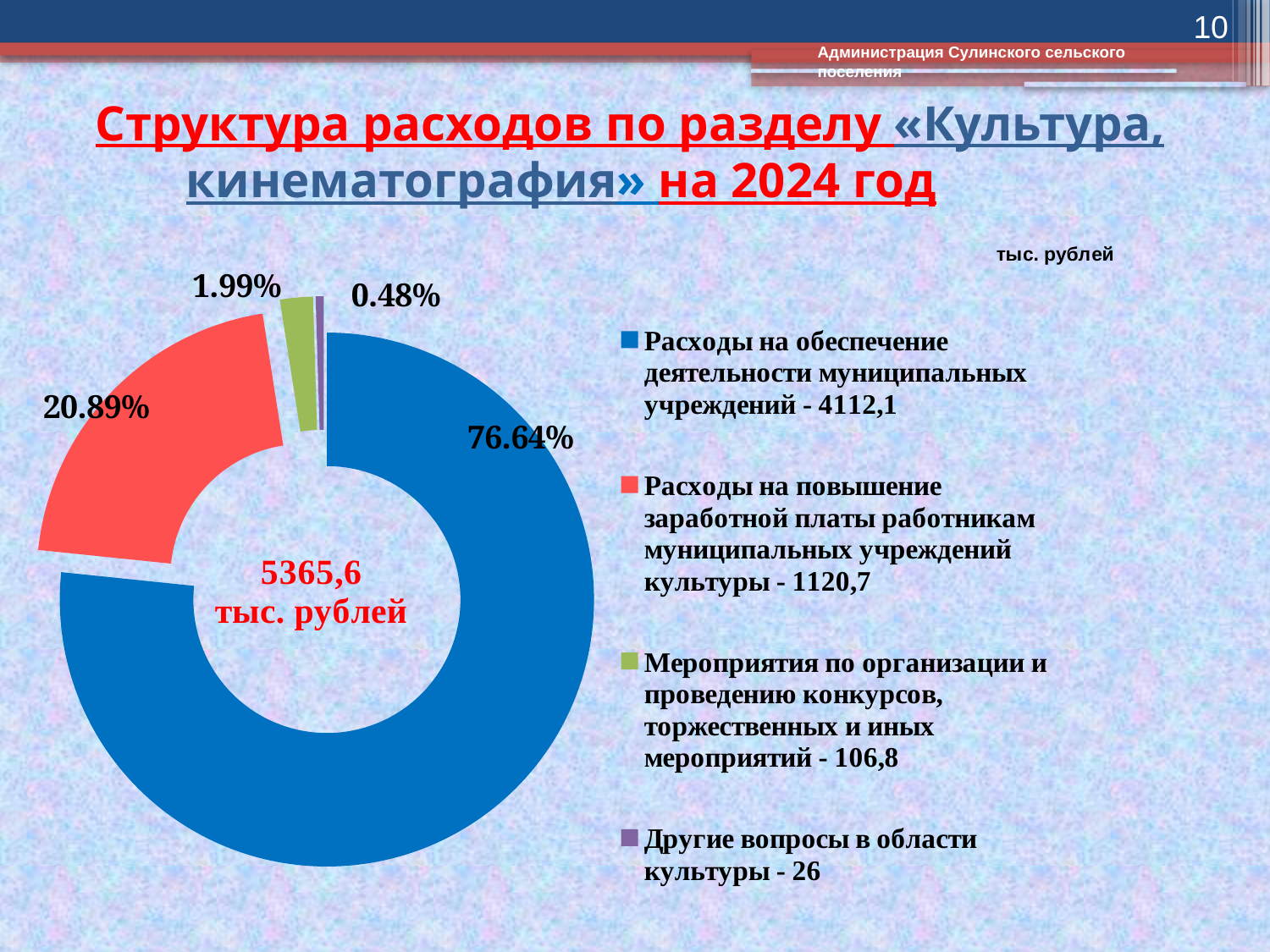
What kind of chart is shown on the slide? Pie (doughnut) chart What share of the chart is labelled for «Мероприятия по организации и проведению конкурсов, торжественных и иных мероприятий»? 1.99% What share of the chart is labelled for «Расходы на повышение заработной платы работникам муниципальных учреждений культуры»? 20.89% What is the difference in тыс. рублей between «Расходы на обеспечение деятельности муниципальных учреждений» (4112,1) and «Расходы на повышение заработной платы работникам муниципальных учреждений культуры» (1120,7)? 2991,4 What amount (тыс. рублей) is given in the legend for «Расходы на обеспечение деятельности муниципальных учреждений»? 4112,1 Which category has the smallest share of the chart? Другие вопросы в области культуры What total amount is shown in the centre of the chart? 5365,6 тыс. рублей What amount (тыс. рублей) is given in the legend for «Другие вопросы в области культуры»? 26 What share of the chart is labelled for «Расходы на обеспечение деятельности муниципальных учреждений»? 76.64% How many categories does the legend list? 4 Which category has the largest share of the chart? Расходы на обеспечение деятельности муниципальных учреждений